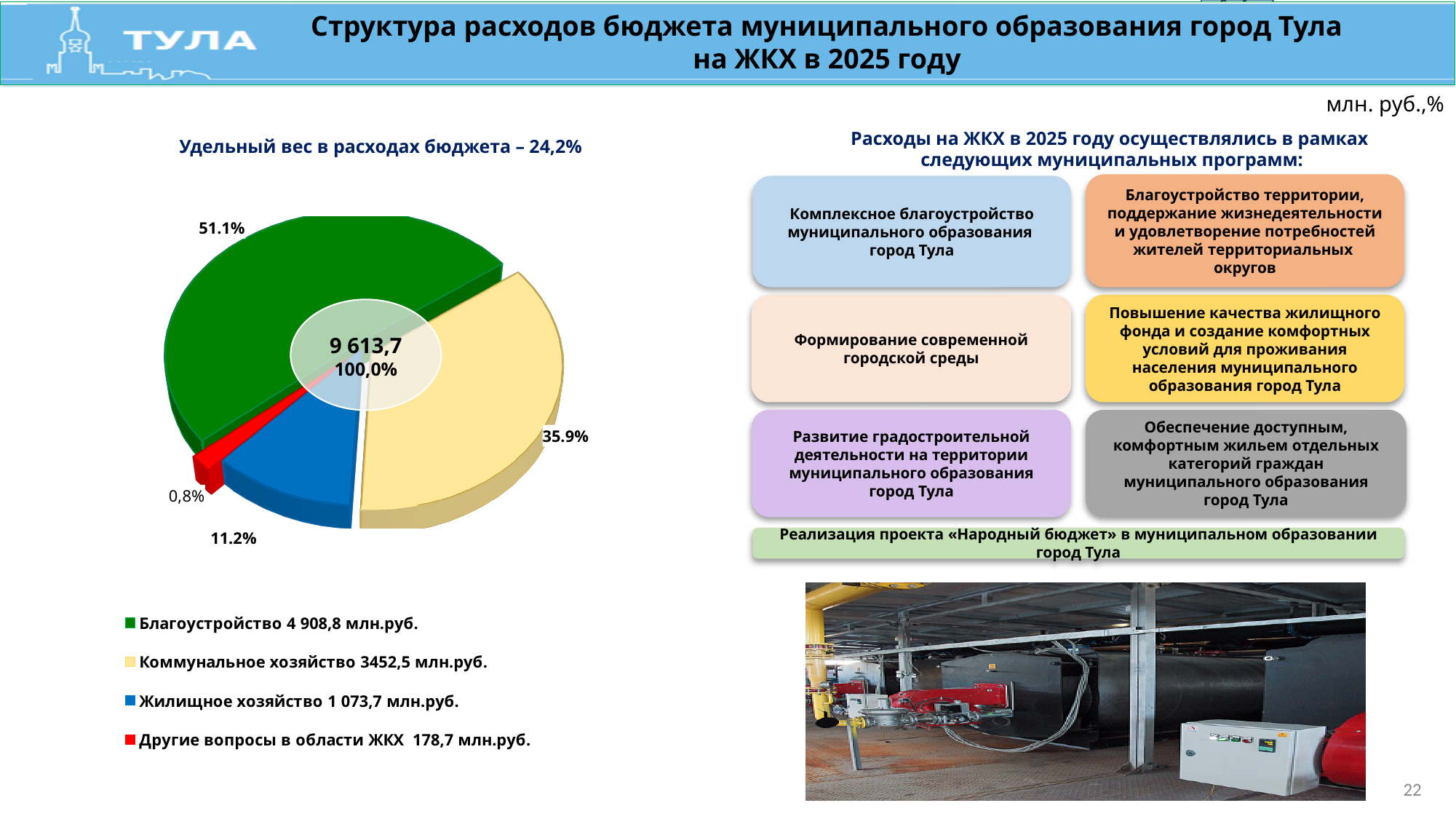
Which is larger: the share for Коммунальное хозяйство or the share for Жилищное хозяйство? Коммунальное хозяйство What kind of chart is shown on the slide? pie chart What share of the pie does Жилищное хозяйство have? 11.2% What total value is shown in the centre of the pie chart? 9 613,7 What share of the pie does Благоустройство have? 51.1% What share of the pie does Коммунальное хозяйство have? 35.9% Which category has the smallest share of the pie? Другие вопросы в области ЖКХ What is the value in млн.руб. for Жилищное хозяйство shown in the legend? 1 073,7 млн.руб. How many slices does the pie chart have? 4 Which category has the largest share of the pie? Благоустройство What is the value in млн.руб. for Благоустройство shown in the legend? 4 908,8 млн.руб.